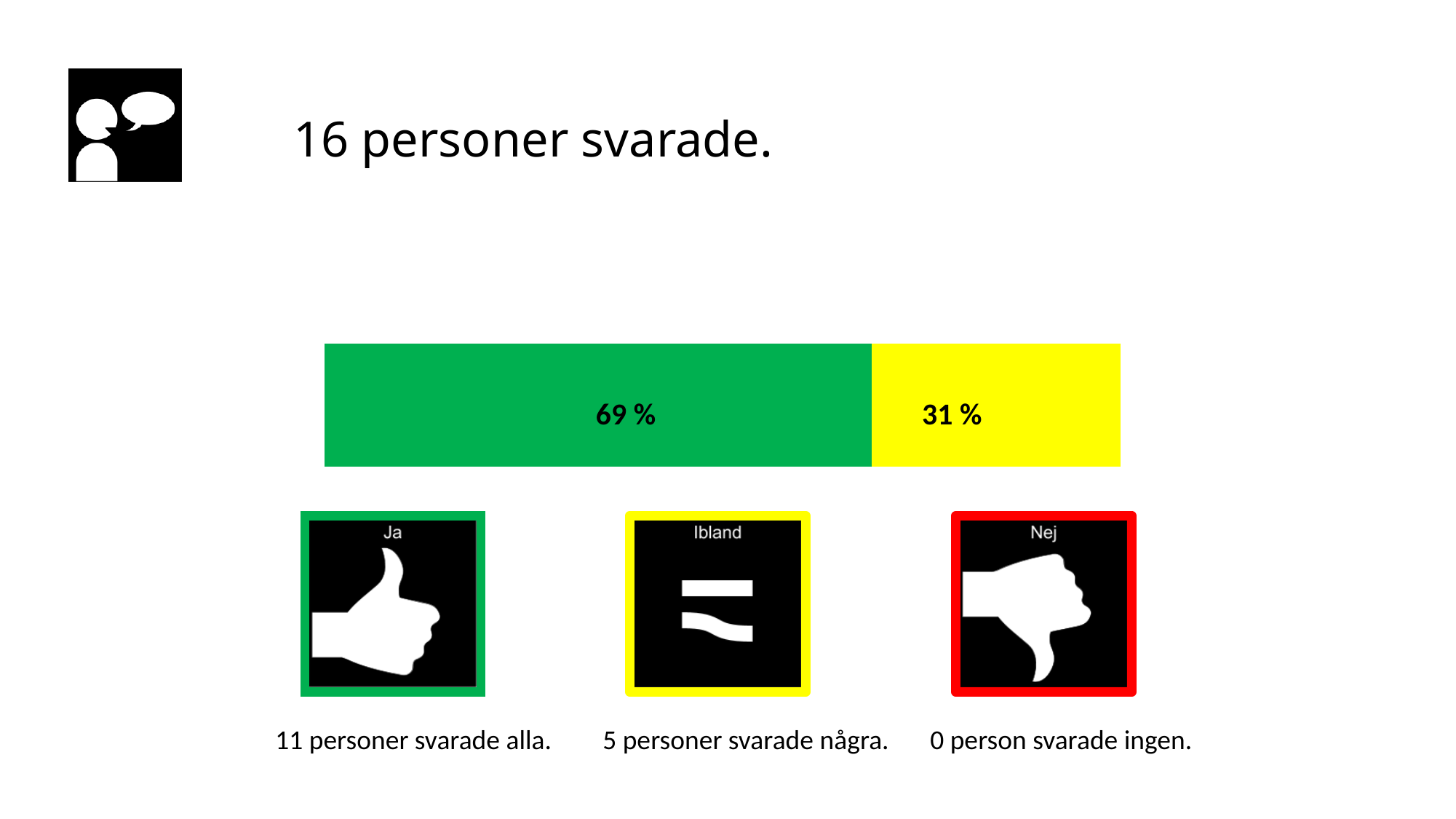
How many segments with printed values does the bar contain? 2 What percentage is shown on the yellow segment of the bar? 31 % How many people answered 'alla' (Ja)? 11 What is the total of the two percentages shown on the bar? 100 % What is the difference in percentage points between the green and yellow segments? 38 Which segment of the bar has the highest percentage? the green segment (69 %) What kind of chart is shown on the slide? a stacked bar chart What percentage is shown on the green segment of the bar? 69 % Which segment of the bar has the lowest percentage? the yellow segment (31 %) How many people answered in total, according to the slide title? 16 How many people answered 'ingen' (Nej)? 0 Which segment of the bar is larger, the green one or the yellow one? the green one